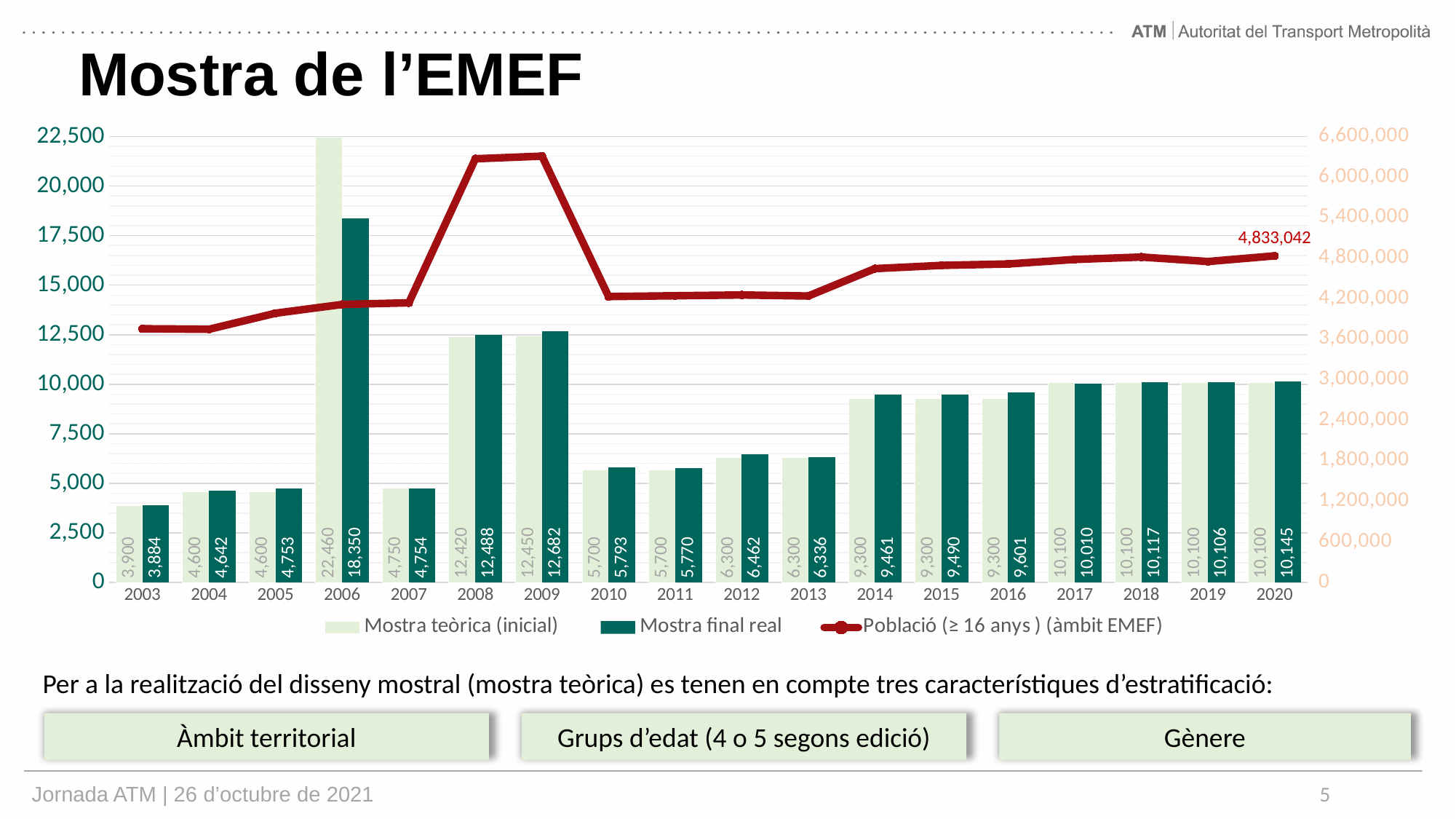
How many series does the legend list? 3 In which year is Mostra teòrica (inicial) highest? 2006 Does Mostra final real rise or fall from 2014 to 2020? rise What kind of chart is shown on the slide? Combined bar and line chart What is the value of Mostra final real for 2006? 18,350 Is the Població (≥ 16 anys) value for 2008 greater or less than 6,000,000? greater What is the value of Mostra teòrica (inicial) for 2008? 12,420 What is the difference between Mostra teòrica (inicial) and Mostra final real in 2006? 4,110 In which year is Mostra final real lowest? 2003 What is the labelled value of Població (≥ 16 anys) for 2020? 4,833,042 How many years are shown on the x axis? 18 In 2017, which is larger: Mostra teòrica (inicial) or Mostra final real? Mostra teòrica (inicial)